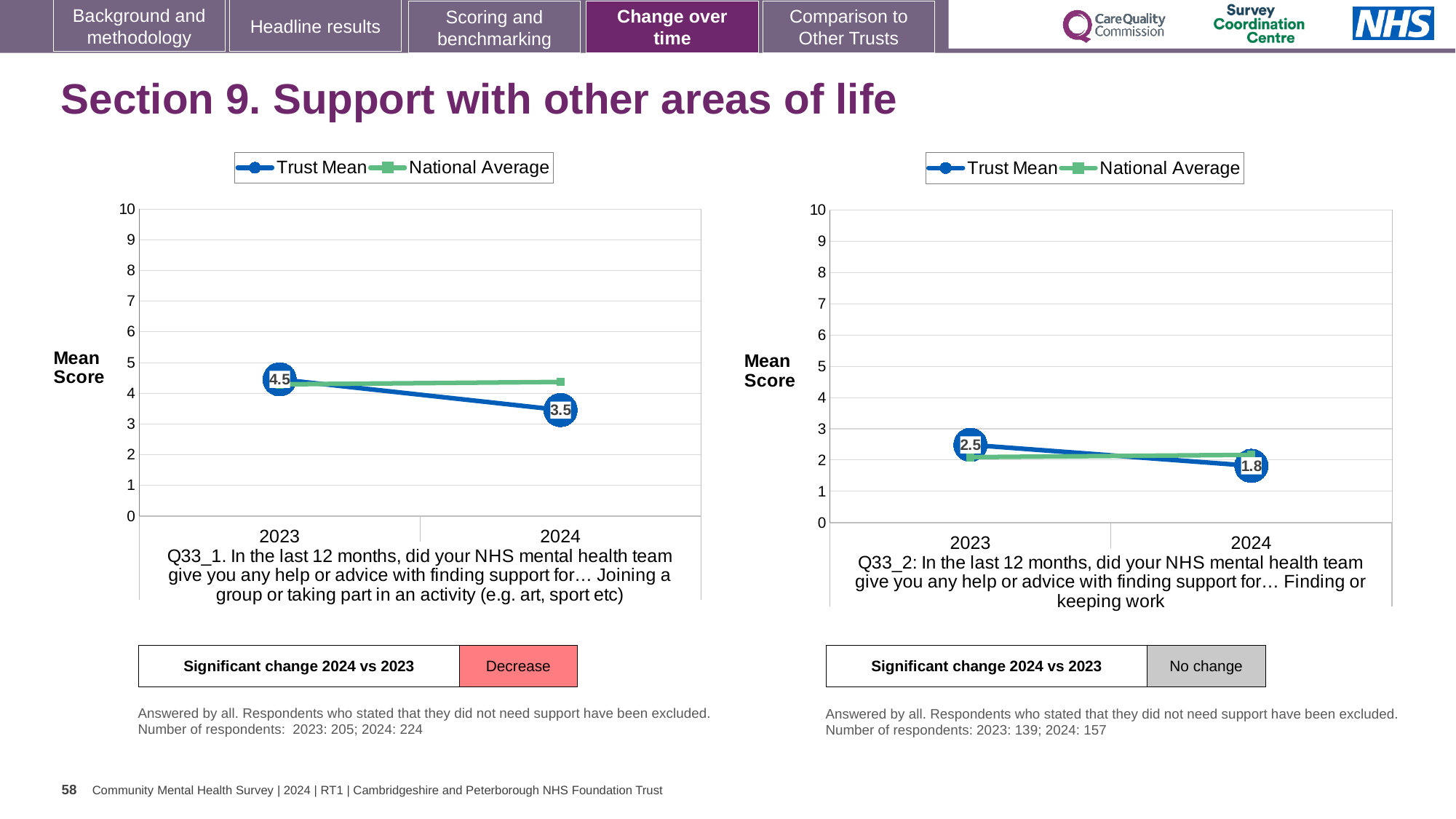
In the left chart (Q33_1), by how much did the Trust Mean fall from 2023 to 2024? 1.0 What type of chart is used on the left (Q33_1)? line chart How many series does the legend of the right chart (Q33_2) list? 2 In the left chart (Q33_1), does the Trust Mean rise or fall from 2023 to 2024? fall In the right chart (Q33_2), what is the Trust Mean for 2024? 1.8 In the left chart (Q33_1), which is higher in 2024, the Trust Mean or the National Average? National Average In the left chart (Q33_1), what is the Trust Mean for 2023? 4.5 In the left chart (Q33_1), what is the Trust Mean for 2024? 3.5 In the left chart (Q33_1), is the National Average for 2024 greater or less than 4? greater In the right chart (Q33_2), what is the Trust Mean for 2023? 2.5 In the right chart (Q33_2), is the Trust Mean for 2024 greater or less than 2? less In the right chart (Q33_2), what is the difference between the Trust Mean in 2023 and 2024? 0.7